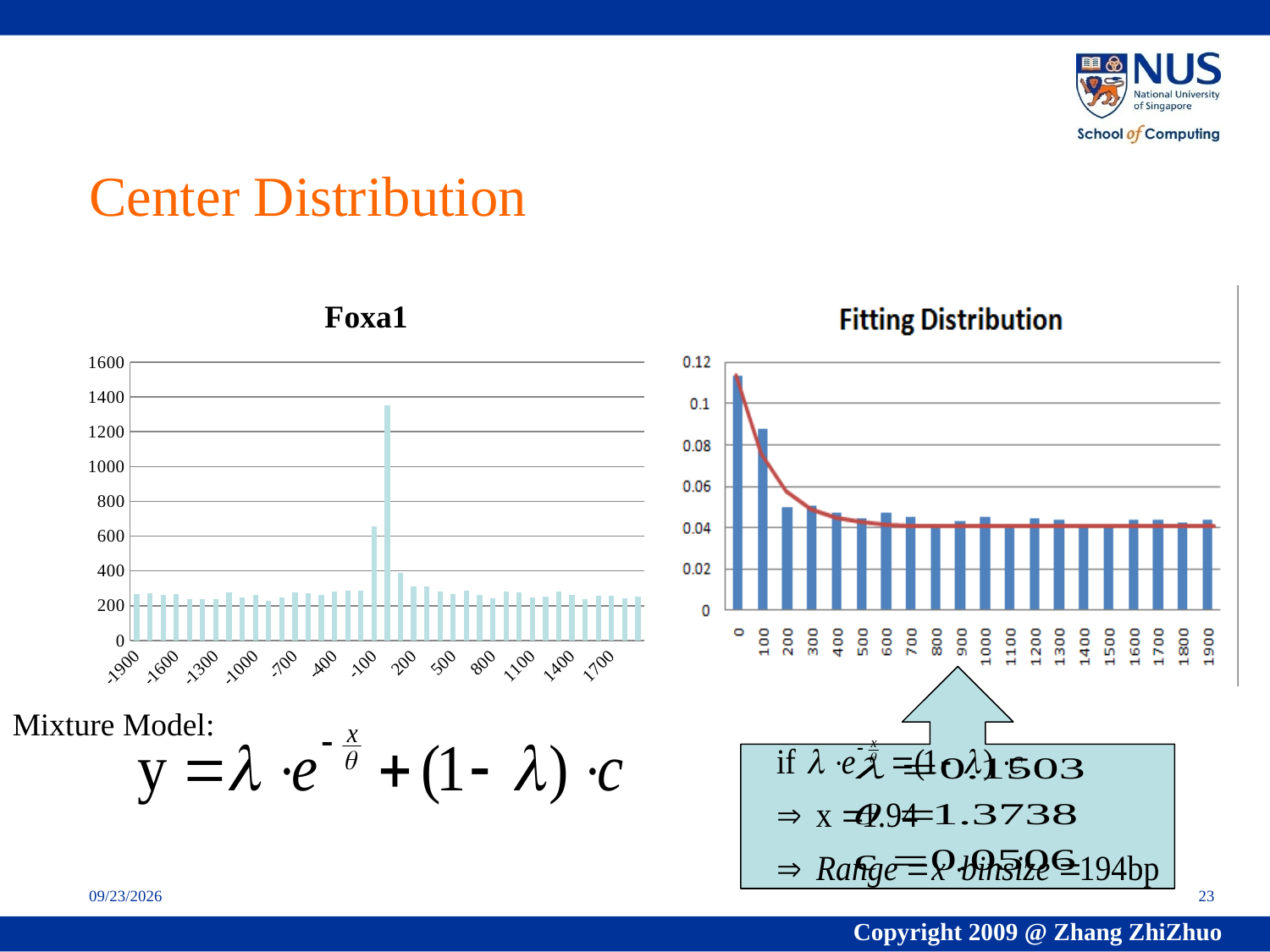
In the Fitting Distribution chart, do the values rise or fall from 0 to 500 along the x axis? fall What kind of chart is the Foxa1 chart on the left? bar chart In the Fitting Distribution chart, is the value for 0 greater or less than 0.1? greater What kind of chart is the Fitting Distribution chart on the right? bar chart How many bars are plotted in the Fitting Distribution chart? 20 What is the highest value shown on the y axis of the Foxa1 chart? 1600 In the Foxa1 chart, is the tallest bar greater or less than 1200? greater In the Fitting Distribution chart, is the value for 200 greater or less than 0.06? less In the Fitting Distribution chart, which is larger, the value for 0 or the value for 100? 0 In the Fitting Distribution chart, which category has the highest value? 0